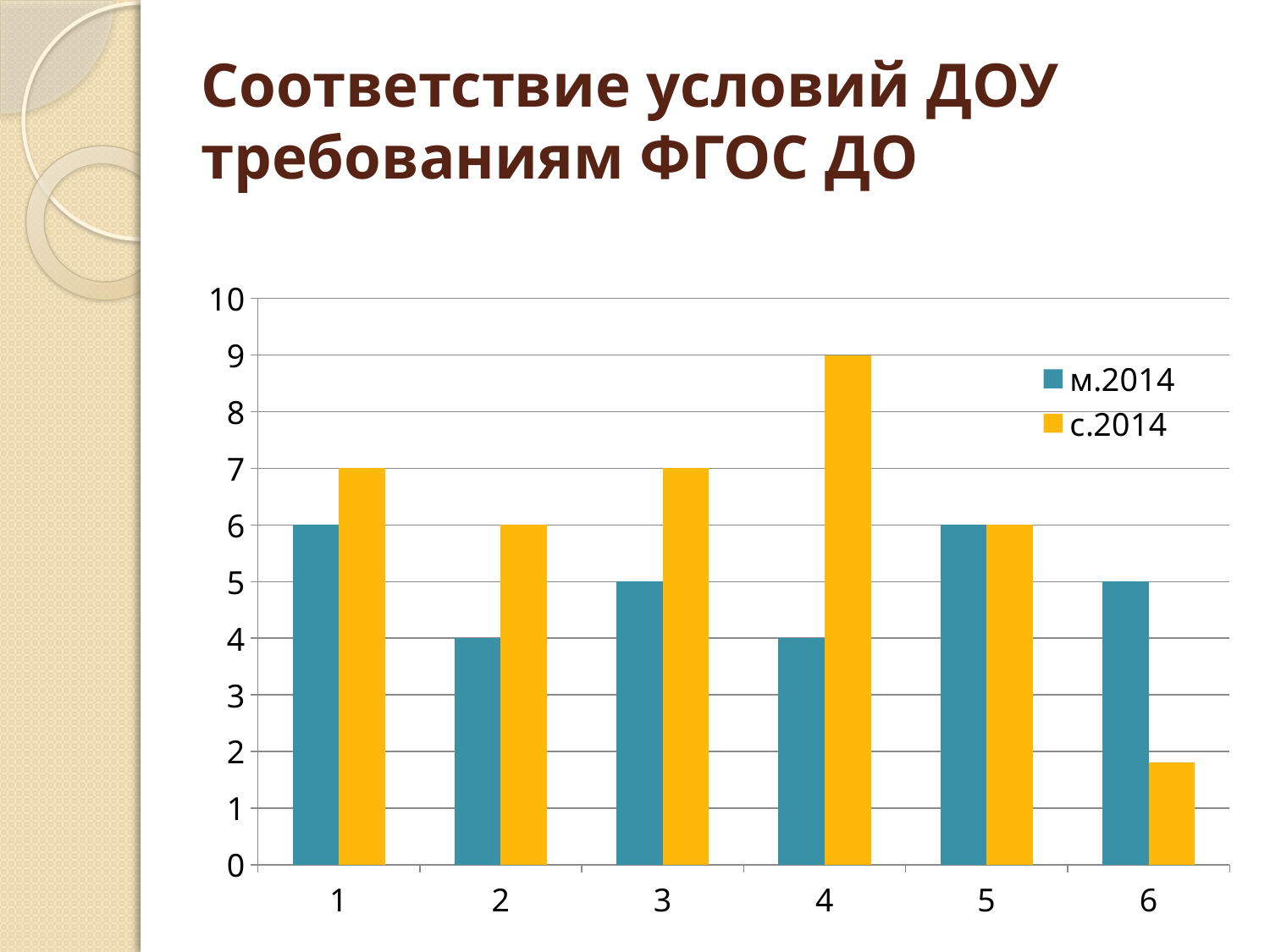
Which category has the lowest value in the с.2014 series? 6 Is the value for category 6 in the с.2014 series greater or less than 3? less What kind of chart is shown on the slide? bar chart For category 3, which series has the larger value, м.2014 or с.2014? с.2014 What is the difference between the с.2014 and м.2014 values for category 4? 5 What is the title of the slide containing the chart? Соответствие условий ДОУ требованиям ФГОС ДО How many categories are shown on the x axis? 6 What is the value for category 4 in the с.2014 series? 9 How many series does the legend list? 2 What is the value for category 2 in the с.2014 series? 6 Which category has the highest value in the с.2014 series? 4 What is the value for category 1 in the м.2014 series? 6